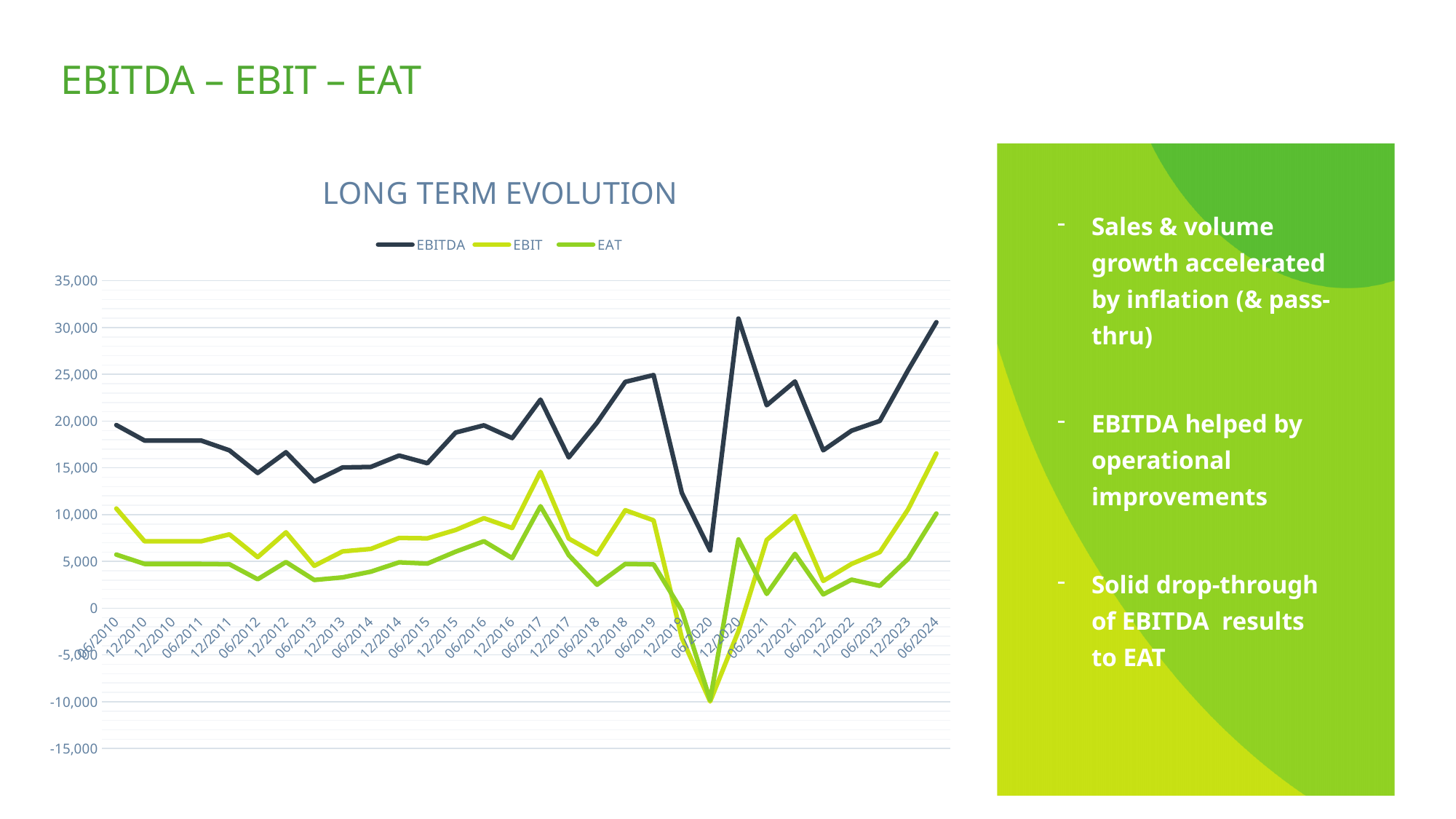
How many series does the legend list? 3 Is the EAT value for 06/2010 greater or less than 10,000? less At which date does the EBIT series reach its lowest value? 06/2020 Which is larger, the EBITDA value for 06/2017 or for 12/2017? 06/2017 How many time points are plotted along the x axis? 30 Is the EBITDA value for 06/2020 greater or less than 10,000? less Is the EBIT value for 06/2024 greater or less than 15,000? greater At which date does the EBITDA series reach its lowest value? 06/2020 What is the title of the chart? LONG TERM EVOLUTION Does the EBITDA series rise or fall between 06/2020 and 12/2020? rise What kind of chart is shown on the slide? line chart